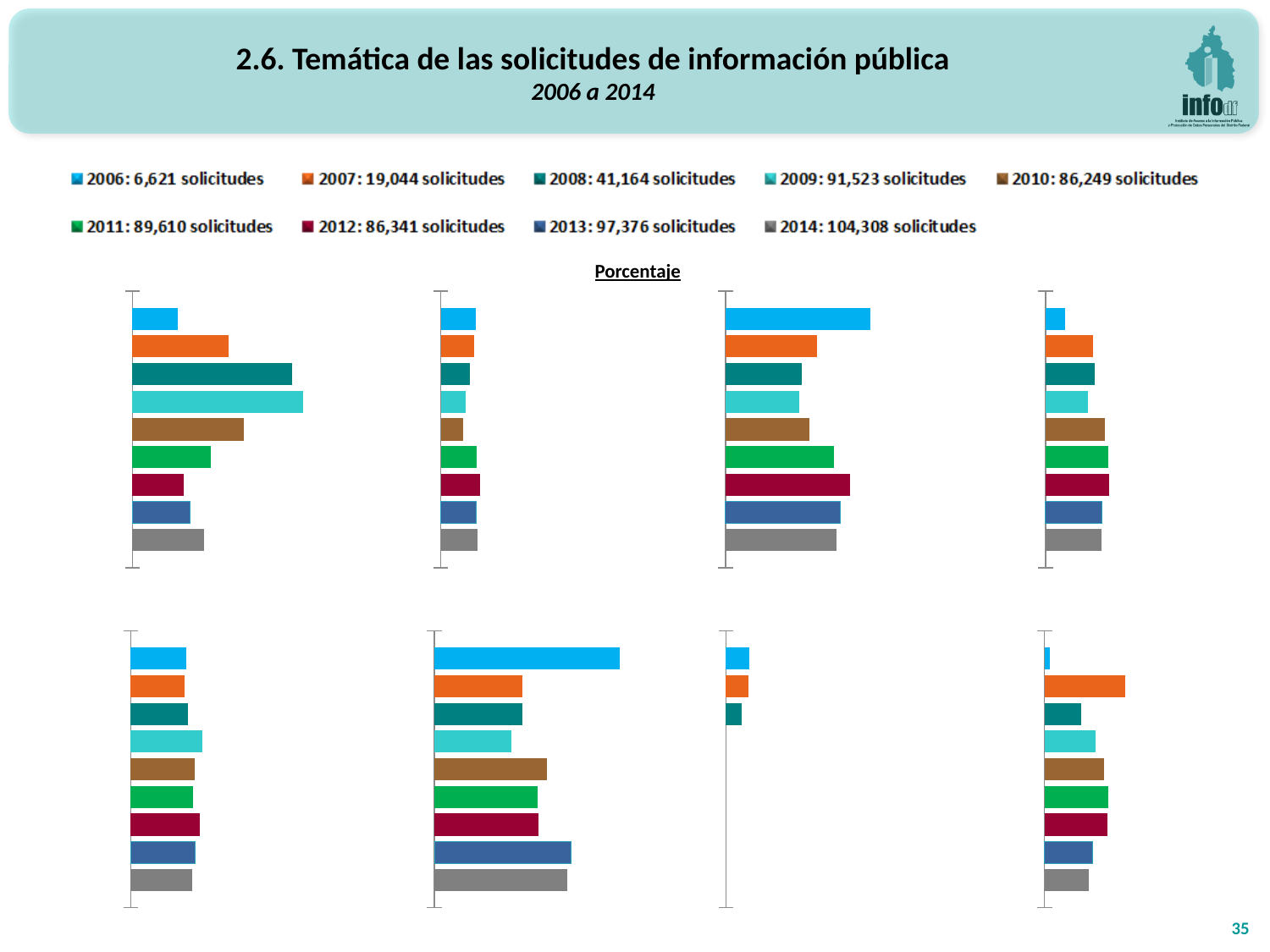
In the first chart from the left in the top row, which year has the longest bar? 2009 In the second chart from the left in the bottom row, which year has the longest bar? 2006 In the first chart from the left in the top row, which bar is longer, 2007 or 2008? 2008 In the third chart from the left in the top row, which year has the longest bar? 2006 How many bars are shown in the third chart from the left in the bottom row? 3 What kind of chart is used in each of the eight small panels on the slide? Bar chart In the fourth chart from the left in the bottom row, which year has the shortest bar? 2006 According to the legend, how many solicitudes were there in 2014? 104,308 solicitudes How many bars are shown in the first chart from the left in the top row? 9 How many series does the legend list? 9 In the third chart from the left in the top row, which bar is longer, 2009 or 2012? 2012